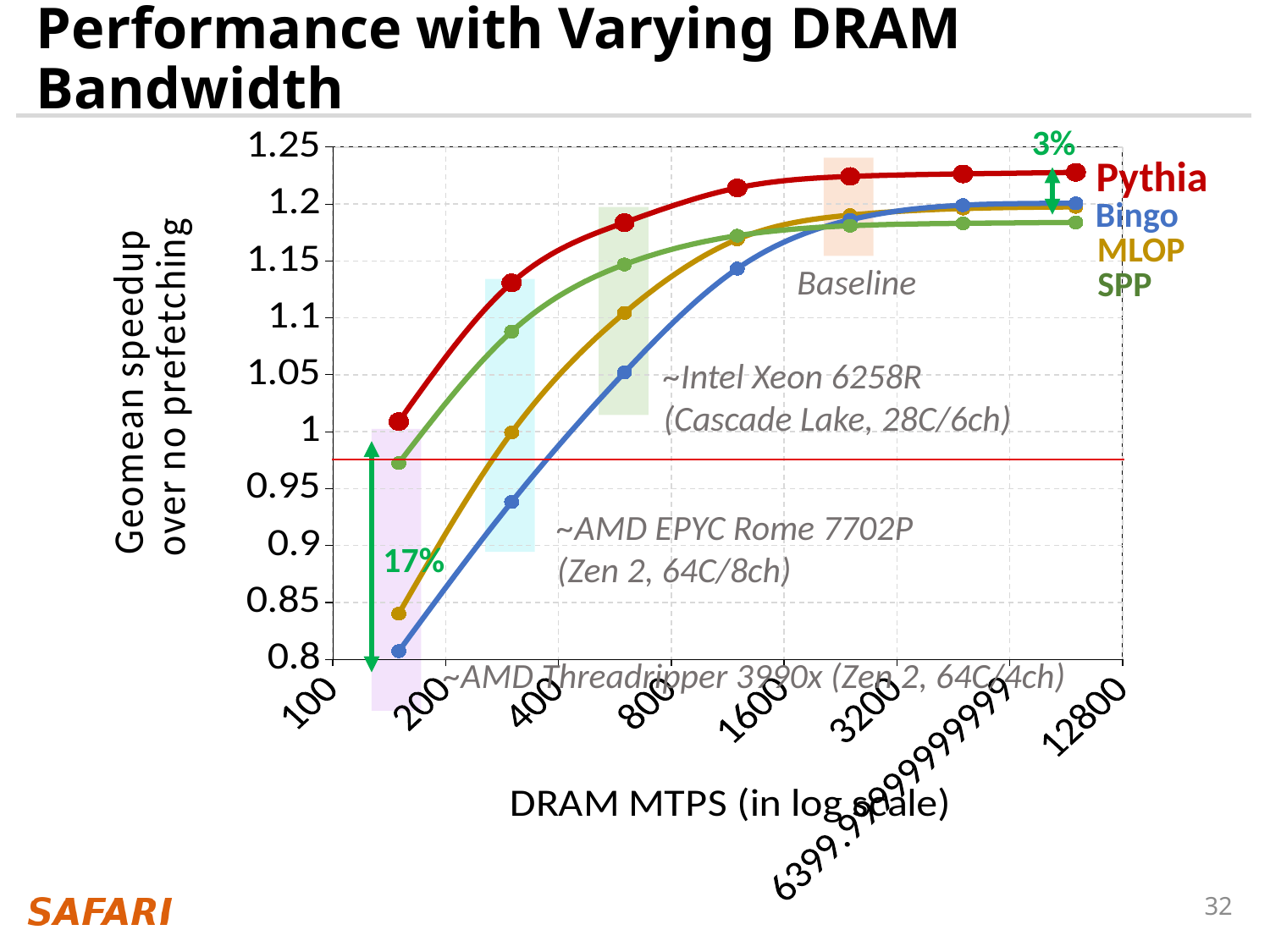
At around 800 DRAM MTPS, which series is higher: Pythia or Bingo? Pythia What kind of chart is shown on the slide? line chart Which series has the highest geomean speedup at the rightmost point (12800 DRAM MTPS)? Pythia Do the geomean speedup values rise or fall as DRAM MTPS increases along the x axis? rise Is the value for Bingo at its leftmost data point greater or less than 0.85? less Which series has the lowest geomean speedup at the leftmost data point? Bingo Is the value for Pythia at its rightmost data point greater or less than 1.2? greater What percentage is annotated next to the green arrow at the highest DRAM bandwidth on the right of the chart? 3% Is the value for MLOP at around 800 DRAM MTPS greater or less than 1.15? less How many series does the chart's legend list? 4 What percentage is annotated next to the green arrow at the lowest DRAM bandwidth on the left of the chart? 17%